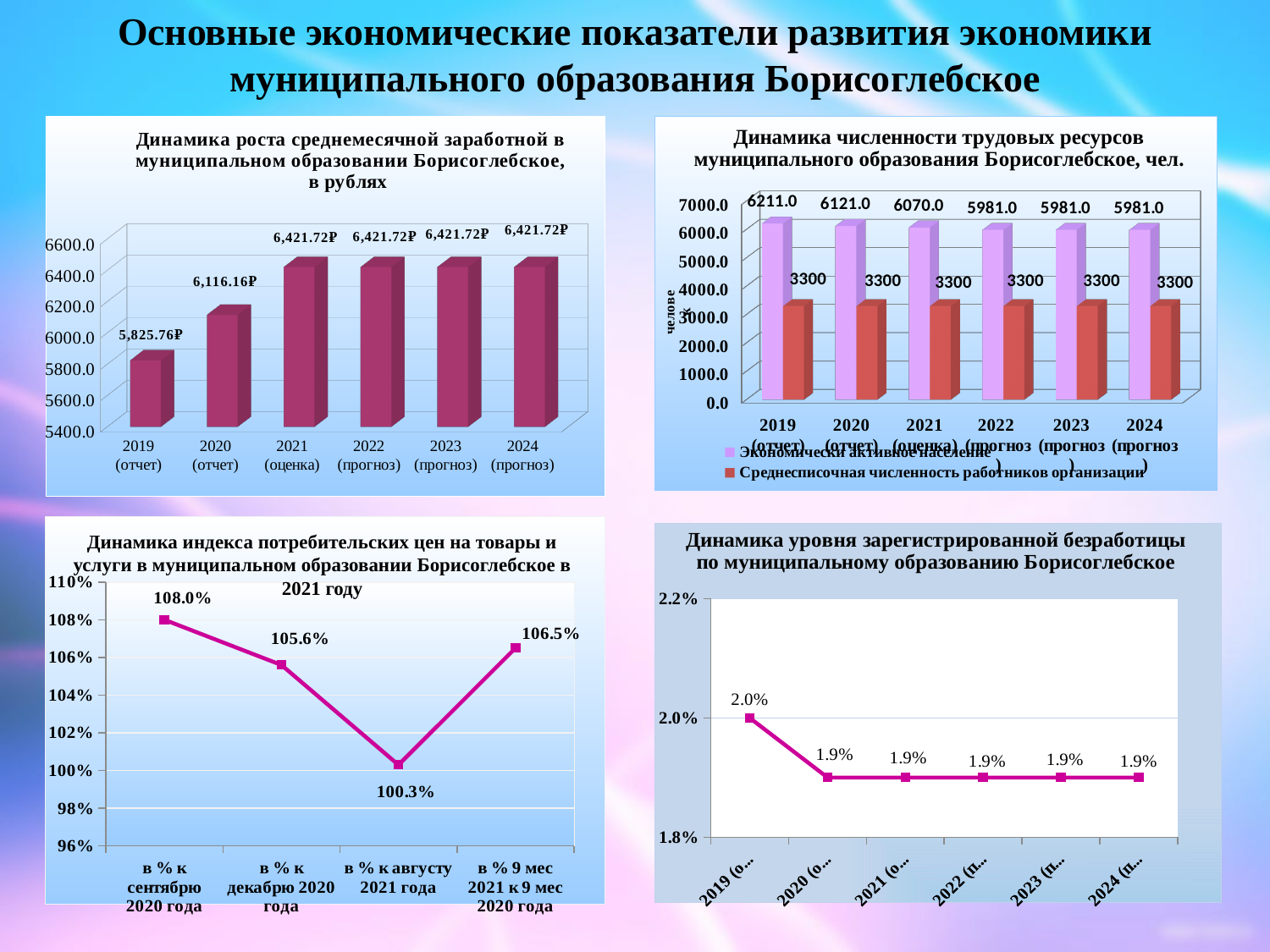
On the bottom-right chart (Динамика уровня зарегистрированной безработицы), what is the value for 2019? 2.0% On the top-right chart (Динамика численности трудовых ресурсов), what is the difference between Экономически активное население in 2019 and in 2021? 141.0 On the top-left chart (Динамика роста среднемесячной заработной платы), how many bars are plotted? 6 On the top-left chart (Динамика роста среднемесячной заработной платы), which year has the lowest value? 2019 (отчет) On the bottom-left chart (Динамика индекса потребительских цен), what is the value for 'в % к августу 2021 года'? 100.3% On the top-left chart (Динамика роста среднемесячной заработной платы), what is the value for 2019 (отчет)? 5,825.76₽ On the top-left chart (Динамика роста среднемесячной заработной платы), what is the value for 2020 (отчет)? 6,116.16₽ On the top-right chart (Динамика численности трудовых ресурсов), what is the value of Среднесписочная численность работников организации for 2022? 3300 On the top-right chart (Динамика численности трудовых ресурсов), how many series does the legend list? 2 On the bottom-left chart (Динамика индекса потребительских цен), which point has the highest value? в % к сентябрю 2020 года What kind of chart is the bottom-right chart (Динамика уровня зарегистрированной безработицы)? line chart On the top-right chart (Динамика численности трудовых ресурсов), what is the value of Экономически активное население for 2019? 6211.0